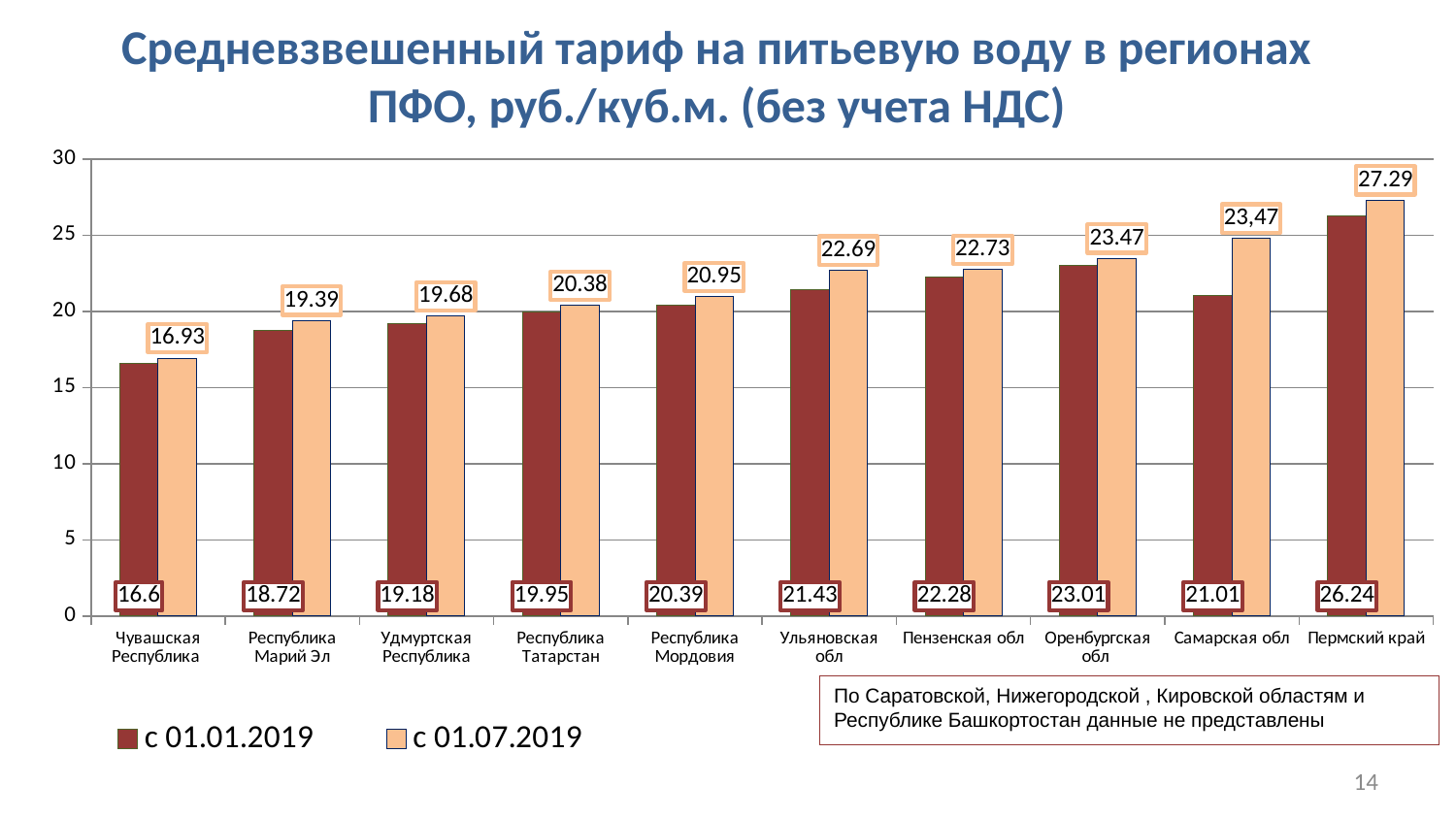
How many regions are shown on the x axis? 10 What is the tariff for Ульяновская обл as of 01.07.2019? 22.69 Which series is shown in dark red in the legend? с 01.01.2019 What type of chart is shown on the slide? bar chart Is the 01.01.2019 tariff for Пермский край greater or less than 25? greater How many series does the legend list? 2 Which is larger: the 01.01.2019 tariff for Оренбургская обл or for Самарская обл? Оренбургская обл What is the tariff for Пермский край as of 01.07.2019? 27.29 Which region has the lowest tariff as of 01.01.2019? Чувашская Республика What is the tariff for Чувашская Республика as of 01.01.2019? 16.6 Which region has the highest tariff as of 01.07.2019? Пермский край